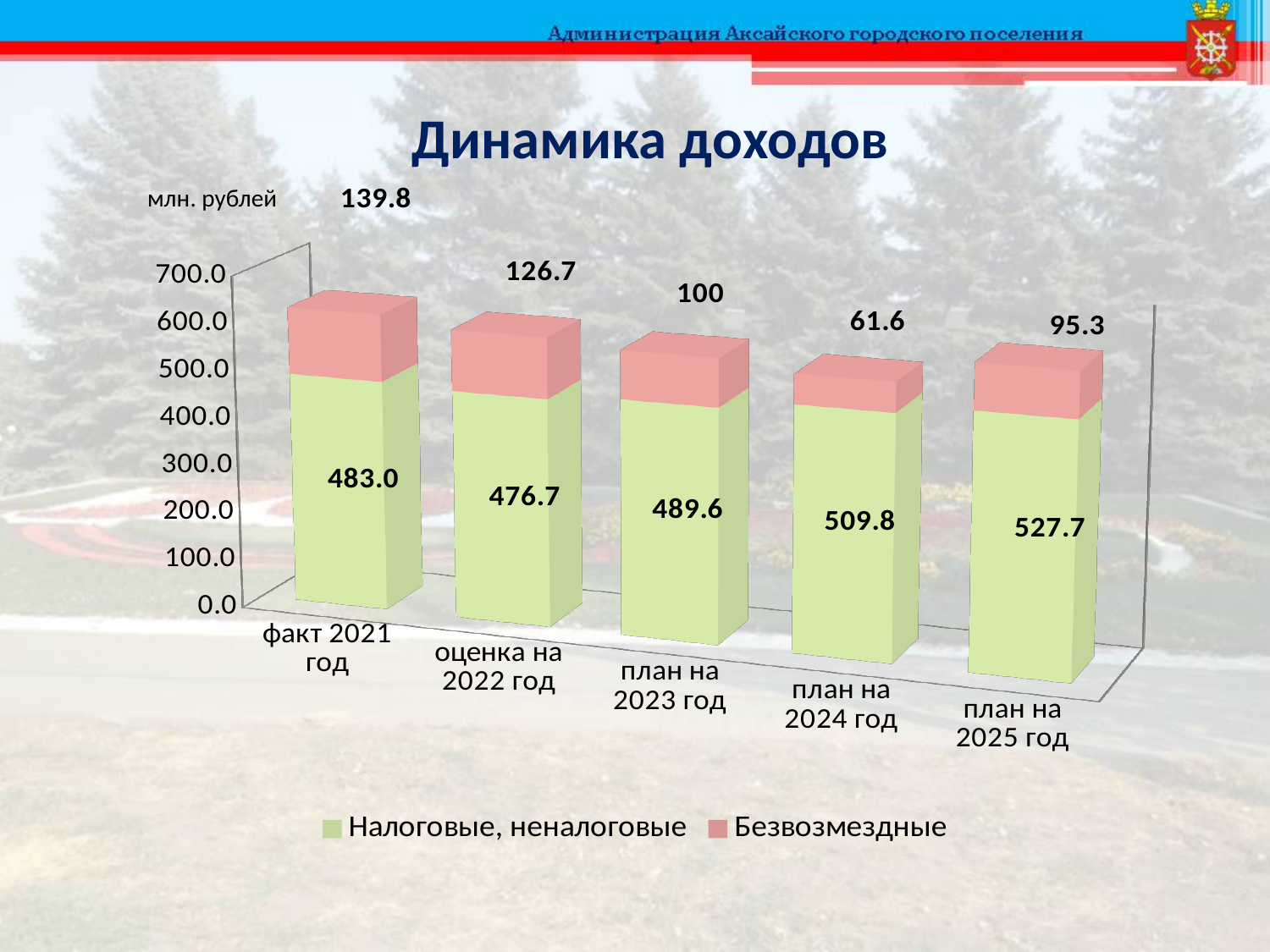
How many series does the legend list? 2 What is the total of the stacked bar for план на 2023 год? 589.6 Which is larger: Безвозмездные for оценка на 2022 год or for план на 2023 год? оценка на 2022 год Which category has the lowest value for Безвозмездные? план на 2024 год What is the value of Налоговые, неналоговые for факт 2021 год? 483.0 Which category has the highest value for Налоговые, неналоговые? план на 2025 год What is the title of the chart? Динамика доходов How many categories are shown on the x axis? 5 What type of chart is shown on the slide? bar chart What is the value of Безвозмездные for план на 2024 год? 61.6 What is the value of Налоговые, неналоговые for план на 2025 год? 527.7 What is the difference between the Налоговые, неналоговые values for план на 2025 год and факт 2021 год? 44.7